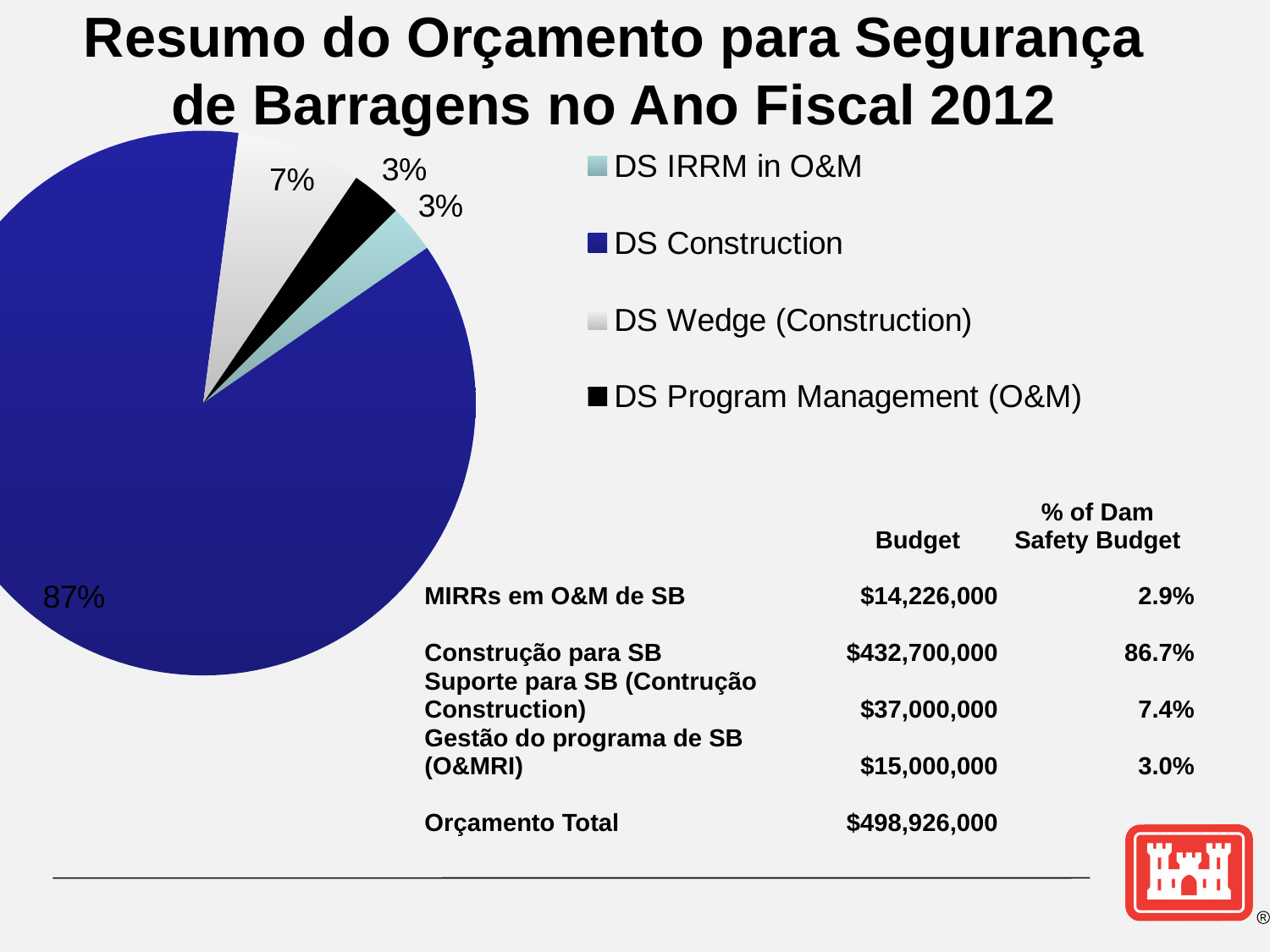
Which slice of the pie chart is the largest? DS Construction What is the difference in percentage points between the DS Construction slice and the DS Wedge (Construction) slice? 80 How many slices does the pie chart have? 4 What share of the pie does DS Construction represent? 87% How many entries does the pie chart's legend list? 4 Which legend entry is shown in black in the pie chart? DS Program Management (O&M) What share of the pie does DS IRRM in O&M represent? 3% What share of the pie does DS Program Management (O&M) represent? 3% What kind of chart is shown on the slide? pie chart Which is larger in the pie chart, DS Wedge (Construction) or DS IRRM in O&M? DS Wedge (Construction) Which legend entry is shown in dark blue in the pie chart? DS Construction